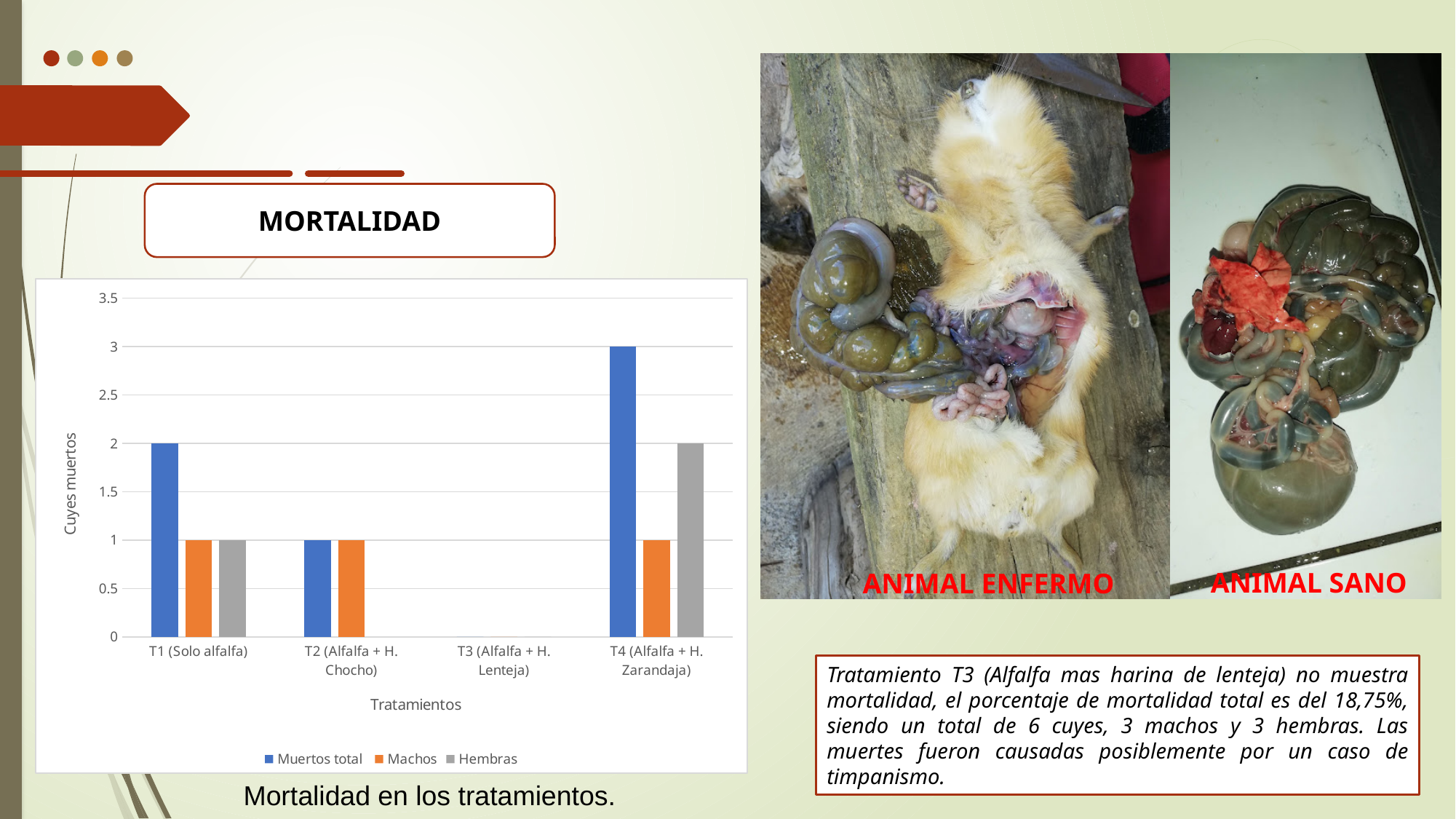
Which is larger for T4 (Alfalfa + H. Zarandaja): Machos or Hembras? Hembras Which treatment has the highest Muertos total? T4 (Alfalfa + H. Zarandaja) What is the value of Muertos total for T1 (Solo alfalfa)? 2 What is the label of the y axis of the chart? Cuyes muertos What is the value of Muertos total for T4 (Alfalfa + H. Zarandaja)? 3 How many series does the chart legend list? 3 How many treatment categories are shown on the x axis of the chart? 4 What is the value of Hembras for T4 (Alfalfa + H. Zarandaja)? 2 What is the difference in Muertos total between T4 (Alfalfa + H. Zarandaja) and T1 (Solo alfalfa)? 1 What kind of chart is shown on the slide? bar chart What is the value of Machos for T2 (Alfalfa + H. Chocho)? 1 Which treatment shows no bars at all (zero deaths)? T3 (Alfalfa + H. Lenteja)